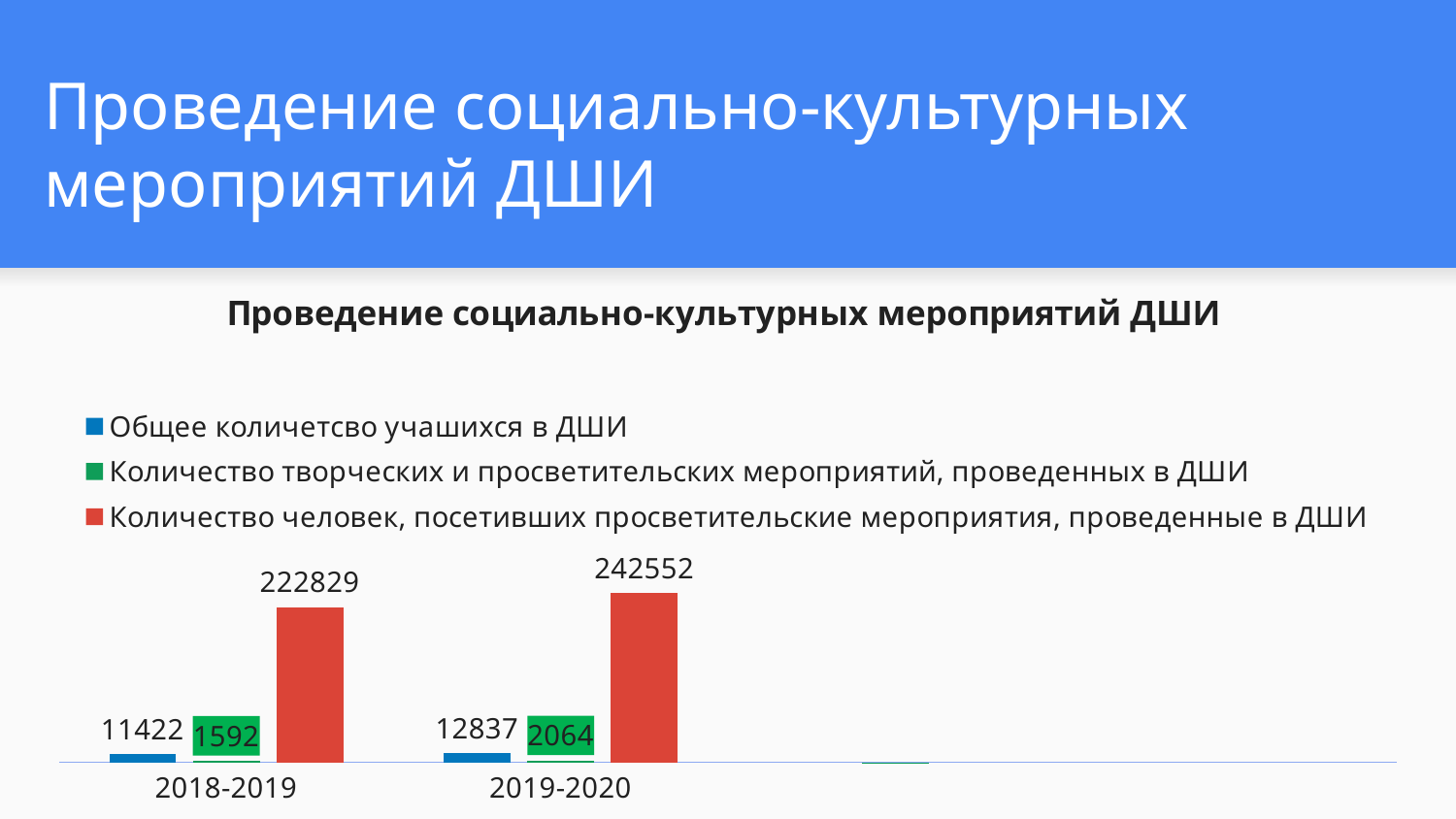
What is the value for 'Количество человек, посетивших просветительские мероприятия, проведенные в ДШИ' in 2018-2019? 222829 Does the value for 'Общее количетсво учашихся в ДШИ' rise or fall from 2018-2019 to 2019-2020? Rise Which series has the lowest value in 2018-2019? Количество творческих и просветительских мероприятий, проведенных в ДШИ Which series has the highest value in 2019-2020? Количество человек, посетивших просветительские мероприятия, проведенные в ДШИ Which is larger: the number of events in 2018-2019 or in 2019-2020? 2019-2020 What is the difference between the 2019-2020 and 2018-2019 values for 'Общее количетсво учашихся в ДШИ'? 1415 What kind of chart is shown on the slide? Bar chart What is the difference between the 2019-2020 and 2018-2019 values for 'Количество человек, посетивших просветительские мероприятия, проведенные в ДШИ'? 19723 What is the value for 'Общее количетсво учашихся в ДШИ' in 2018-2019? 11422 What is the value for 'Количество творческих и просветительских мероприятий, проведенных в ДШИ' in 2019-2020? 2064 How many series does the legend list? 3 What is the value for 'Количество человек, посетивших просветительские мероприятия, проведенные в ДШИ' in 2019-2020? 242552